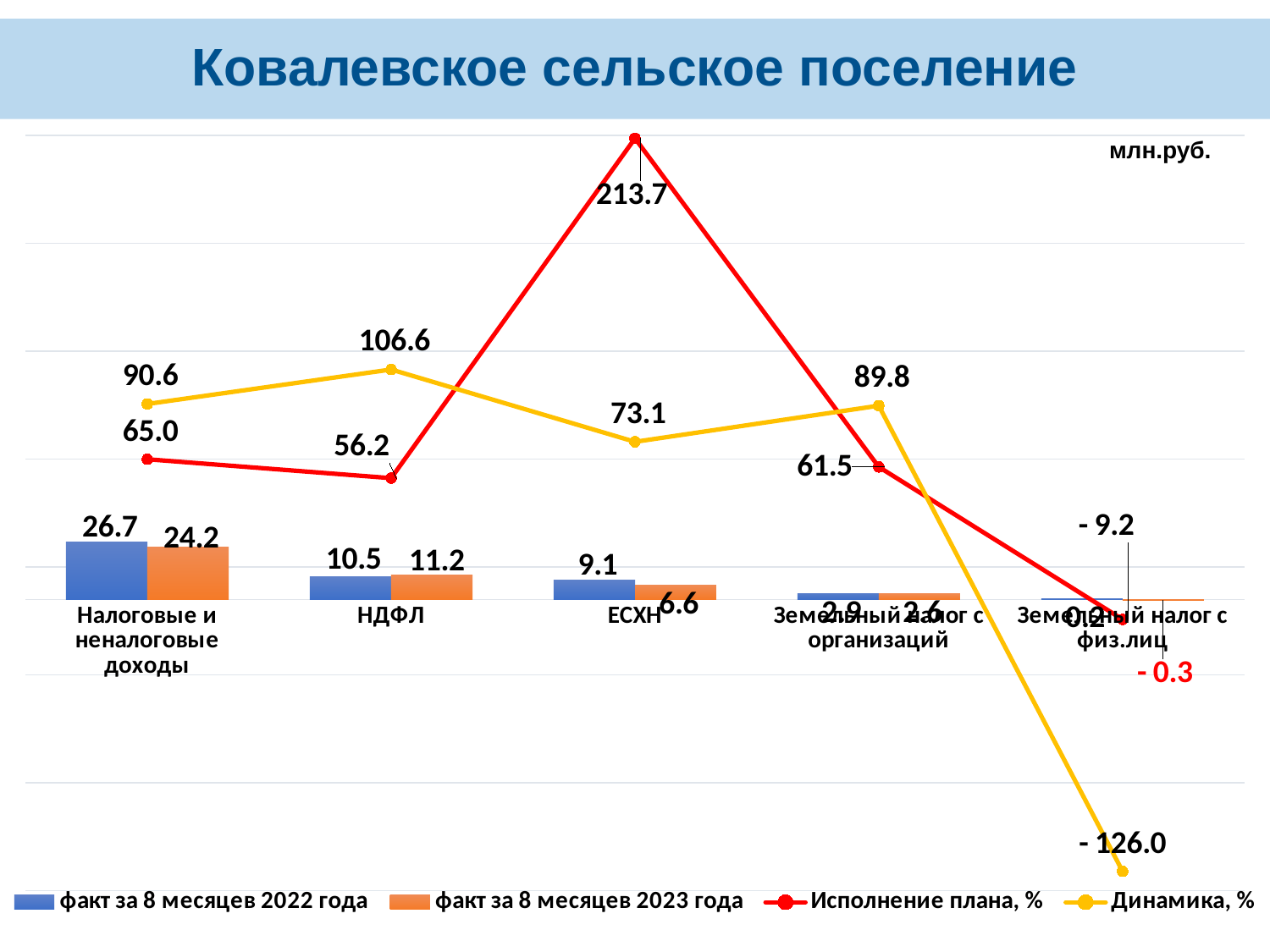
What kind of chart is shown on the slide? A combined bar and line chart Which category has the highest value of 'Исполнение плана, %'? ЕСХН How many series does the legend list? 4 Which category has the lowest value of 'Динамика, %'? Земельный налог с физ.лиц For НДФЛ, which is larger: 'факт за 8 месяцев 2022 года' or 'факт за 8 месяцев 2023 года'? факт за 8 месяцев 2023 года What unit is indicated in the top right corner of the chart? млн.руб. What is the value of 'Динамика, %' for НДФЛ? 106.6 What is the value of 'Исполнение плана, %' for ЕСХН? 213.7 What is the value of 'факт за 8 месяцев 2022 года' for НДФЛ? 10.5 What is the difference between 'факт за 8 месяцев 2022 года' and 'факт за 8 месяцев 2023 года' for 'Налоговые и неналоговые доходы'? 2.5 Which category has the highest value of 'факт за 8 месяцев 2022 года'? Налоговые и неналоговые доходы How many categories are shown along the x axis? 5